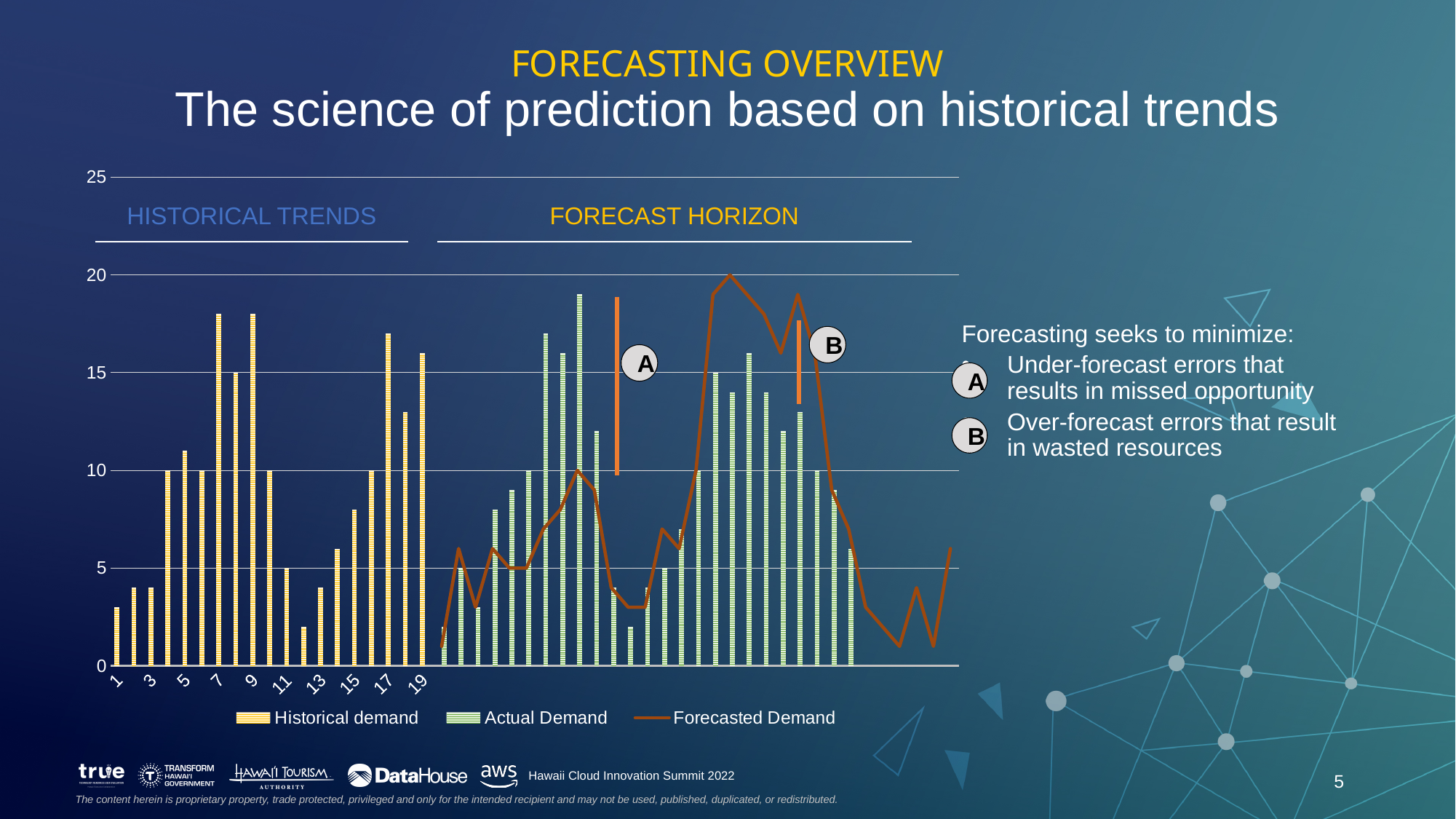
Is the Historical demand value for category 1 greater or less than 5? less What kind of chart is shown on the slide? bar chart with a line What are the three series named in the chart legend? Historical demand, Actual Demand, Forecasted Demand Which has the larger Historical demand value, category 19 or category 11? category 19 How many series does the chart legend list? 3 Does the Historical demand generally rise or fall from category 1 to category 7? rise Is the Historical demand value for category 19 greater or less than 15? greater Is the Historical demand value for category 7 greater or less than 15? greater What is the Historical demand value for category 11? 5 What is the highest value shown on the chart's vertical axis? 25 Which has the larger Historical demand value, category 7 or category 1? category 7